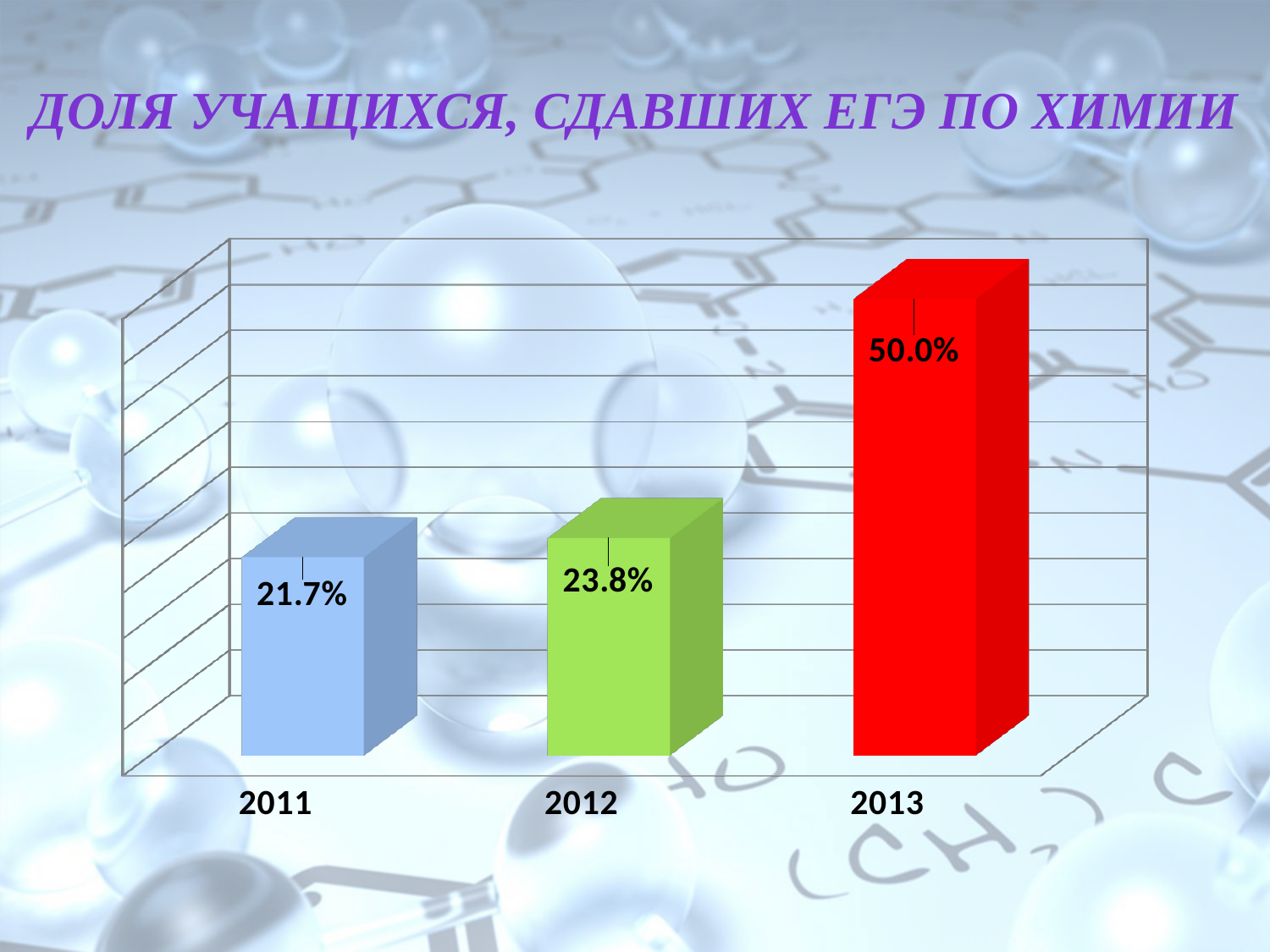
What is the difference between the values for 2012 and 2011? 2.1% Do the values rise or fall from 2011 to 2013? rise Which year has the lowest value? 2011 What is the value for 2012? 23.8% What colour is the bar for 2013? red What kind of chart is shown on the slide? bar chart How many years are shown on the chart? 3 Which is larger, the value for 2011 or the value for 2013? 2013 What is the value for 2011? 21.7% What is the value for 2013? 50.0% Which year has the highest value? 2013 What is the difference between the values for 2013 and 2012? 26.2%